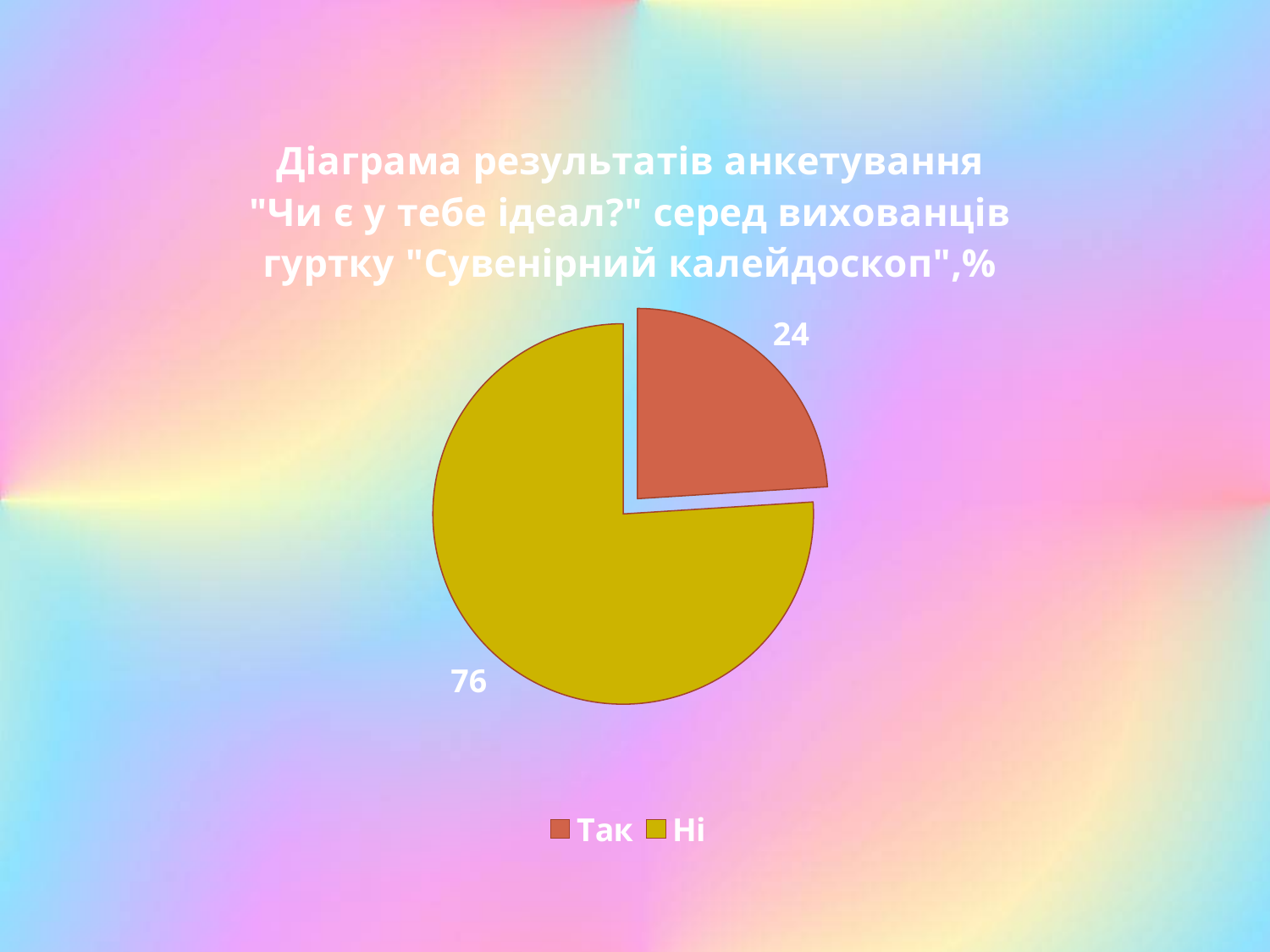
Which category has the largest slice? Ні How many entries does the legend list? 2 What is the difference between the values for "Ні" and "Так"? 52 What kind of chart is shown on the slide? pie chart How many slices does the pie chart have? 2 What is the value for "Так"? 24 What share of the pie does the "Так" slice represent? 24% What is the value for "Ні"? 76 What is the total of the two slice values? 100 What colour is the "Ні" slice? yellow Which category has the smallest slice? Так Which is larger, the value for "Так" or the value for "Ні"? Ні